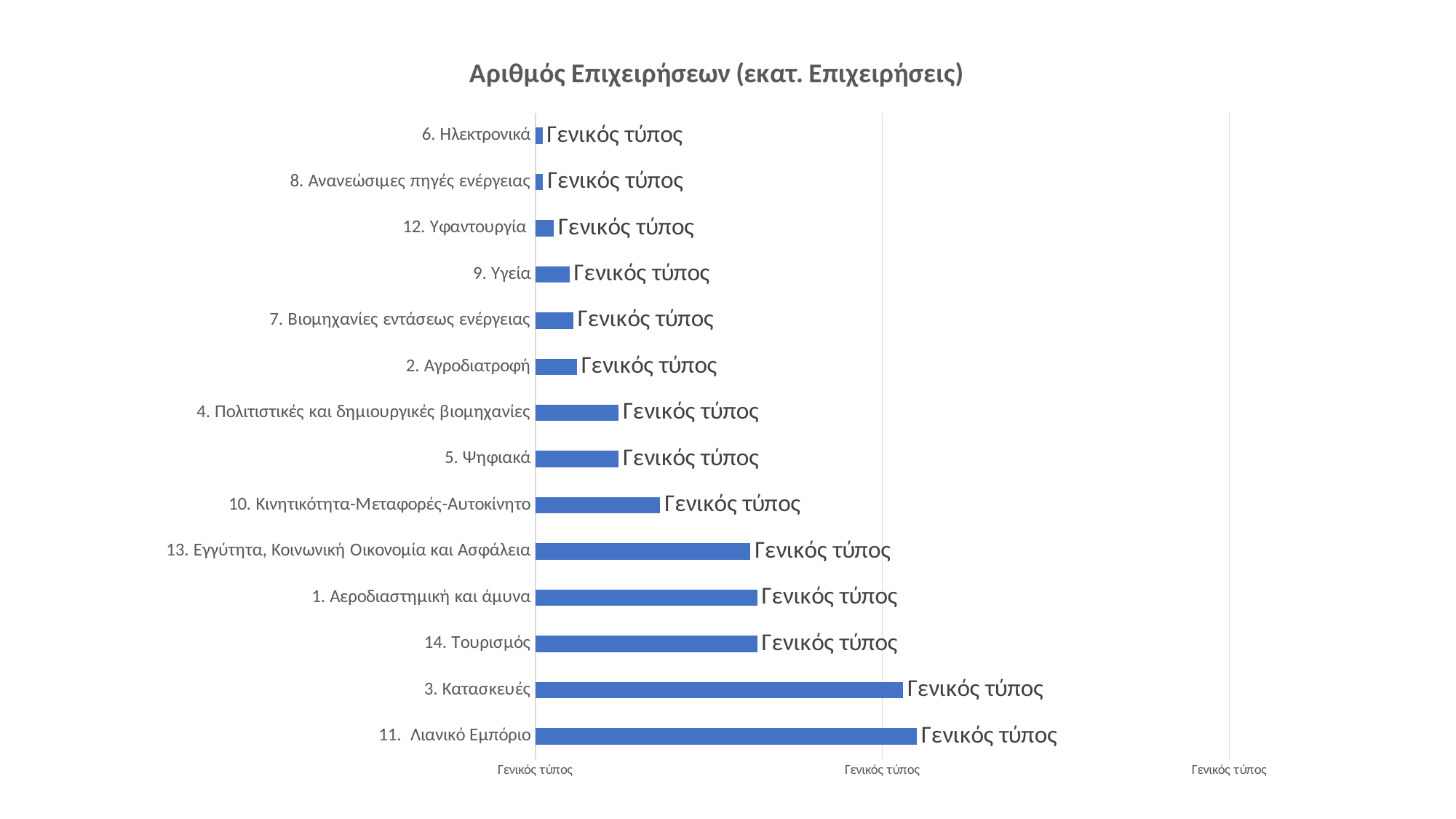
Which bar is longer: 10. Κινητικότητα-Μεταφορές-Αυτοκίνητο or 5. Ψηφιακά? 10. Κινητικότητα-Μεταφορές-Αυτοκίνητο What text is shown as the data label next to each bar? Γενικός τύπος Going from the top of the chart to the bottom, do the bars get longer or shorter? Longer Which bar is longer: 3. Κατασκευές or 14. Τουρισμός? 3. Κατασκευές What kind of chart is shown on the slide? Bar chart How many categories (bars) does the chart show? 14 Which category has the longest bar in the chart? 11. Λιανικό Εμπόριο What is the title of the chart? Αριθμός Επιχειρήσεων (εκατ. Επιχειρήσεις) Which bar is longer: 13. Εγγύτητα, Κοινωνική Οικονομία και Ασφάλεια or 2. Αγροδιατροφή? 13. Εγγύτητα, Κοινωνική Οικονομία και Ασφάλεια